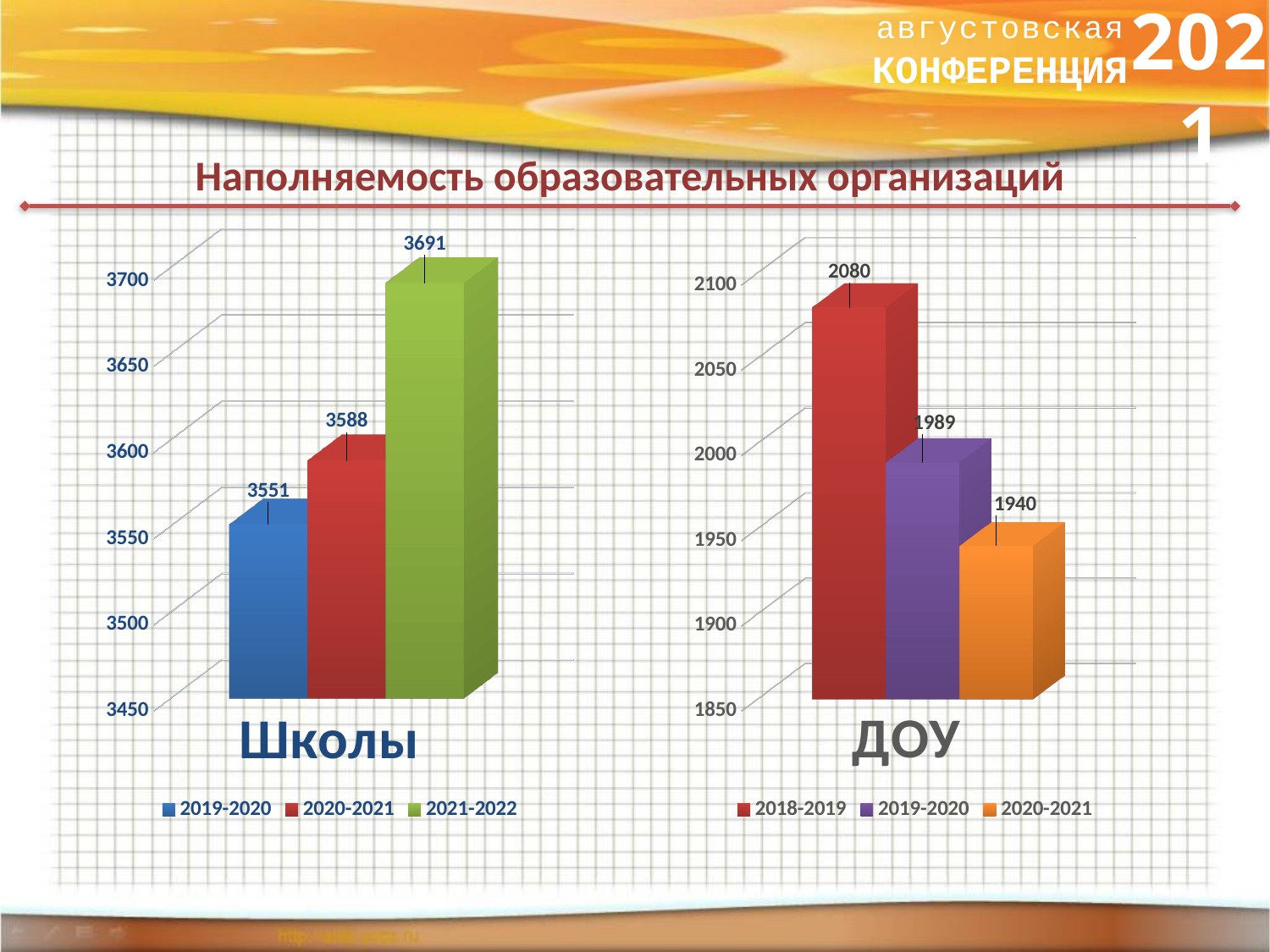
In the right chart (ДОУ), what is the value for 2020-2021? 1940 In the left chart (Школы), which series has the highest value? 2021-2022 In the left chart (Школы), what is the difference between the 2021-2022 and 2020-2021 values? 103 In the right chart (ДОУ), what is the difference between the 2018-2019 and 2019-2020 values? 91 What kind of chart is the right chart (ДОУ)? bar chart In the right chart (ДОУ), what is the value for 2018-2019? 2080 In the right chart (ДОУ), do the values rise or fall from 2018-2019 to 2020-2021? fall In the left chart (Школы), what is the value for 2019-2020? 3551 How many series does the legend of the left chart (Школы) list? 3 In the right chart (ДОУ), which series has the lowest value? 2020-2021 In the left chart (Школы), what is the value for 2021-2022? 3691 In the right chart (ДОУ), which is larger: the value for 2019-2020 or the value for 2020-2021? 2019-2020